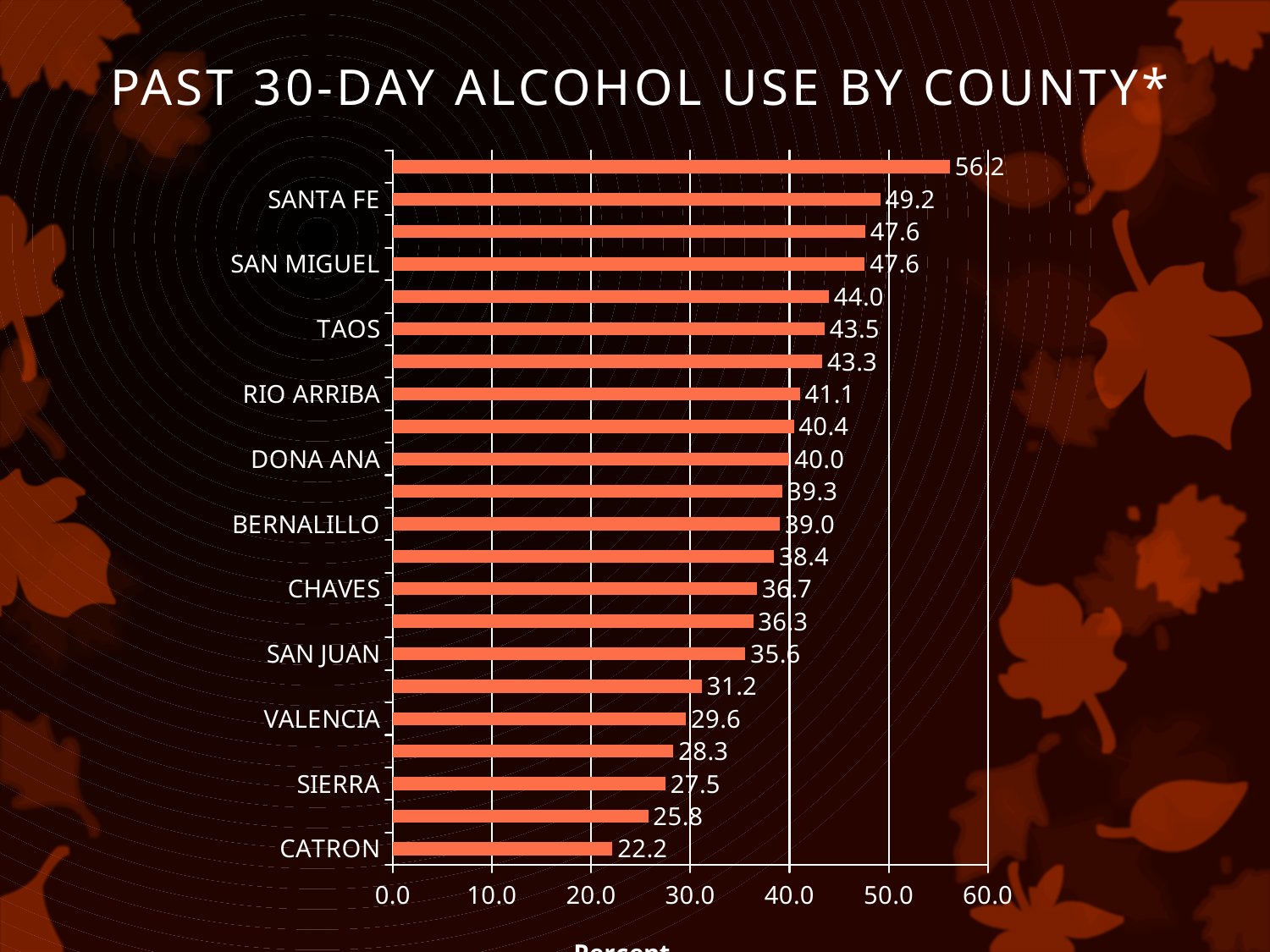
How many bars are plotted on the chart? 22 What is the past 30-day alcohol use value for Santa Fe? 49.2 Is the value for Valencia greater or less than 30.0? less What is the value for Rio Arriba? 41.1 What value is shown for Bernalillo? 39.0 What is the highest value shown on the chart? 56.2 What is the difference between the values for Santa Fe and Catron? 27.0 What value is shown for Catron? 22.2 Which labeled county has the lowest value? Catron What is the title of the chart? PAST 30-DAY ALCOHOL USE BY COUNTY* Which has a larger value, Taos or Rio Arriba? Taos What kind of chart is shown on the slide? Bar chart